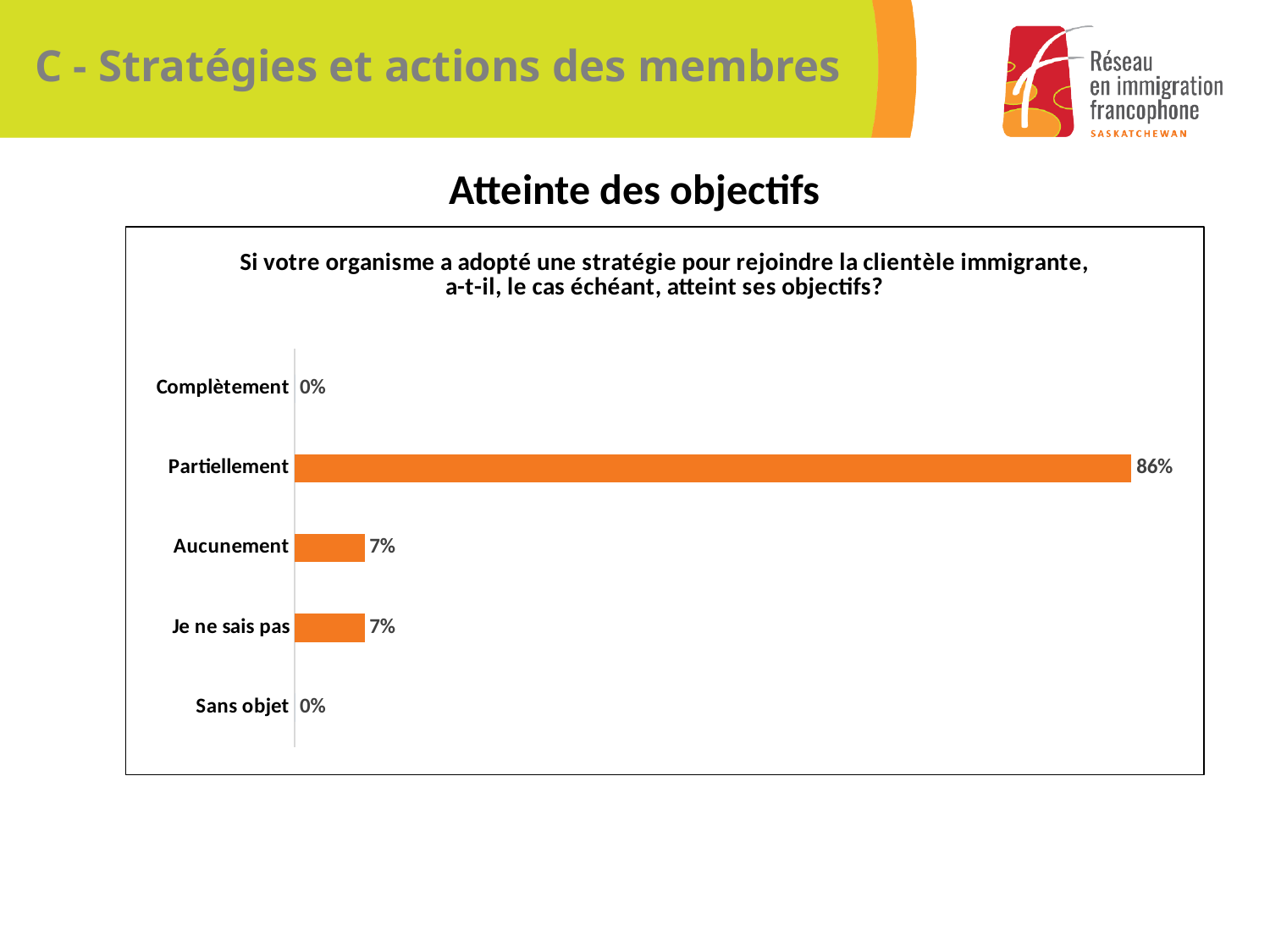
What is the value for Sans objet? 0% What is the value for Aucunement? 7% Which is larger, the value for Partiellement or the value for Je ne sais pas? Partiellement What kind of chart is shown on the slide? Bar chart What is the title of the chart? Si votre organisme a adopté une stratégie pour rejoindre la clientèle immigrante, a-t-il, le cas échéant, atteint ses objectifs? Which category has the highest value? Partiellement What is the value for Partiellement? 86% What is the value for Complètement? 0% How many categories are shown in the chart? 5 What colour are the bars in the chart? Orange What is the difference between the values for Partiellement and Aucunement? 79% What is the total of the values for Aucunement and Je ne sais pas? 14%